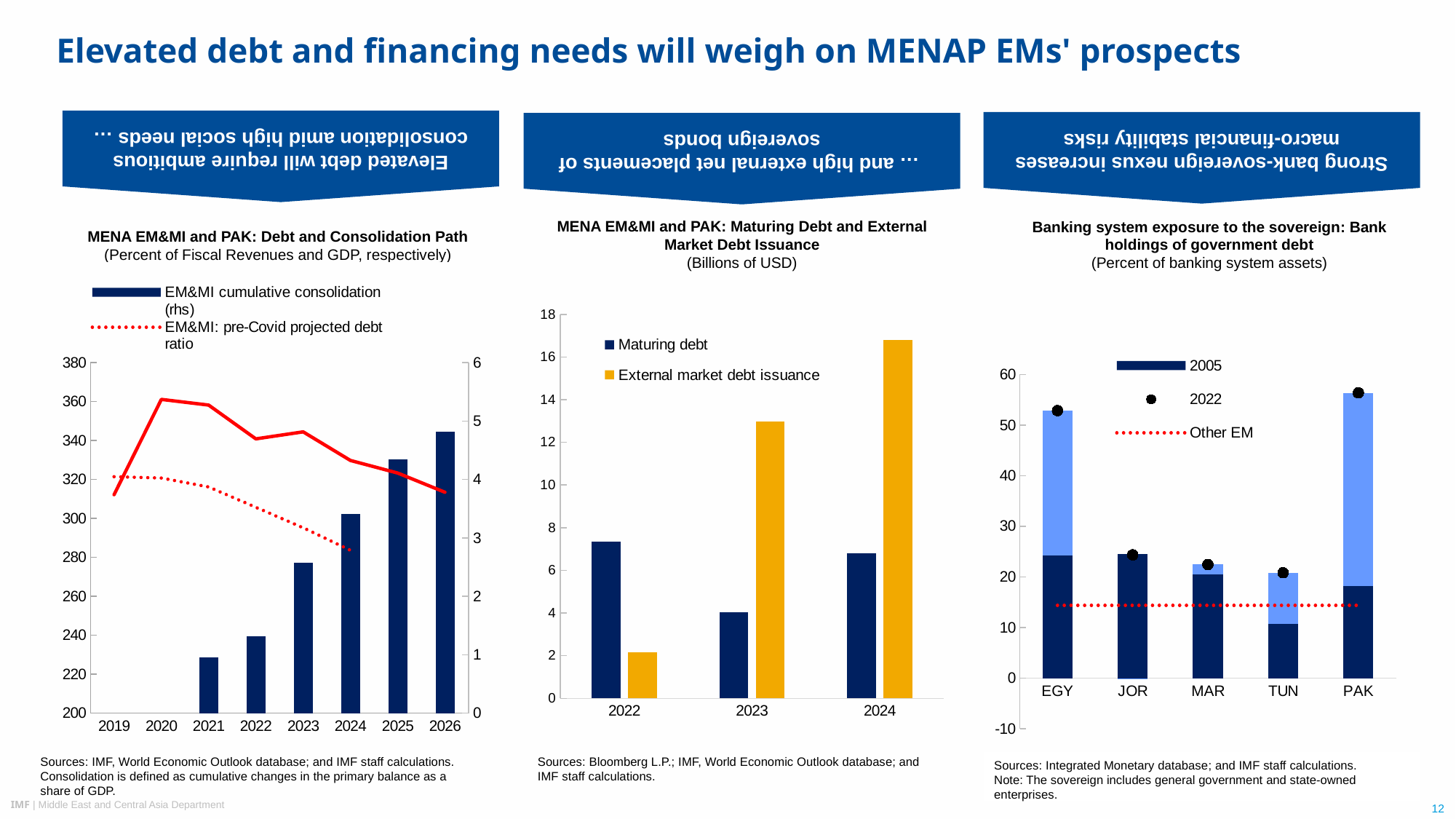
What kind of chart is the 'MENA EM&MI and PAK: Maturing Debt and External Market Debt Issuance' chart? bar chart In the 'Banking system exposure to the sovereign' chart, which country has the highest 2022 value? PAK In the 'MENA EM&MI and PAK: Debt and Consolidation Path' chart, which year has the highest EM&MI cumulative consolidation bar? 2026 In the 'MENA EM&MI and PAK: Debt and Consolidation Path' chart, is the EM&MI cumulative consolidation bar for 2021 greater or less than 2 on the right-hand axis? less In the 'MENA EM&MI and PAK: Debt and Consolidation Path' chart, do the EM&MI cumulative consolidation bars rise or fall from 2021 to 2026? rise How many countries are shown on the x axis of the 'Banking system exposure to the sovereign' chart? 5 In the 'MENA EM&MI and PAK: Maturing Debt and External Market Debt Issuance' chart, in 2022 which is larger, maturing debt or external market debt issuance? Maturing debt In the 'MENA EM&MI and PAK: Maturing Debt and External Market Debt Issuance' chart, which year has the highest external market debt issuance? 2024 In the 'MENA EM&MI and PAK: Maturing Debt and External Market Debt Issuance' chart, is external market debt issuance in 2024 greater or less than 16? greater In the 'Banking system exposure to the sovereign' chart, is the 2022 value for EGY greater or less than 50? greater In the 'MENA EM&MI and PAK: Maturing Debt and External Market Debt Issuance' chart, which year has the lowest maturing debt? 2023 How many series does the legend of the 'MENA EM&MI and PAK: Maturing Debt and External Market Debt Issuance' chart list? 2